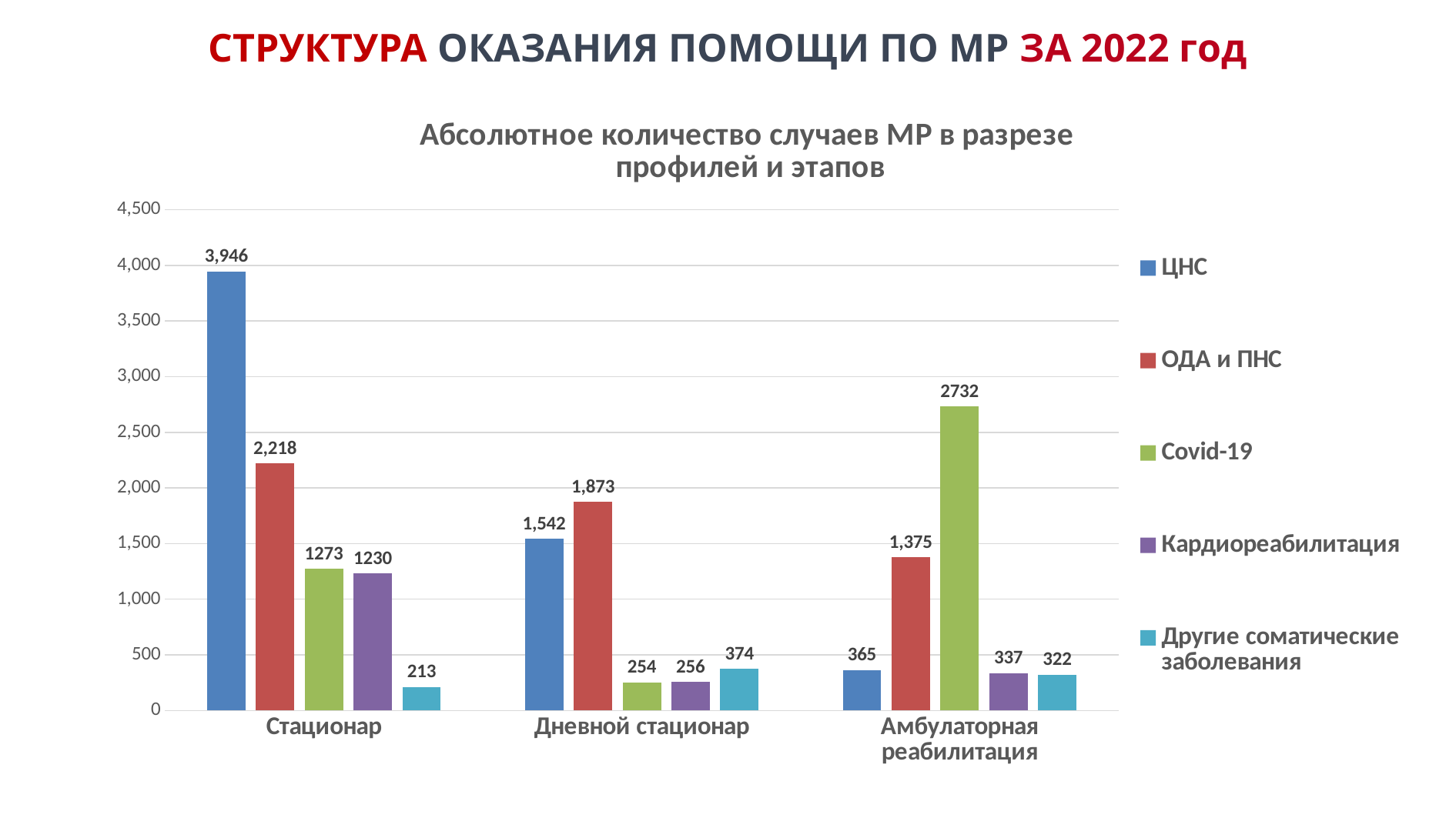
What kind of chart is shown on the slide? bar chart What is the title of the chart? Абсолютное количество случаев МР в разрезе профилей и этапов How many series does the legend list? 5 How many categories are shown on the x axis? 3 Is the value for ОДА и ПНС in the Амбулаторная реабилитация category greater or less than 1,500? less Which series has the lowest value in the Стационар category? Другие соматические заболевания Which series has the highest value in the Дневной стационар category? ОДА и ПНС What is the difference between the ЦНС and ОДА и ПНС values in the Стационар category? 1,728 Which is larger: Кардиореабилитация in Стационар or Кардиореабилитация in Амбулаторная реабилитация? Стационар What is the value for Другие соматические заболевания in the Дневной стационар category? 374 What is the value for Covid-19 in the Амбулаторная реабилитация category? 2732 What is the value for ЦНС in the Стационар category? 3,946